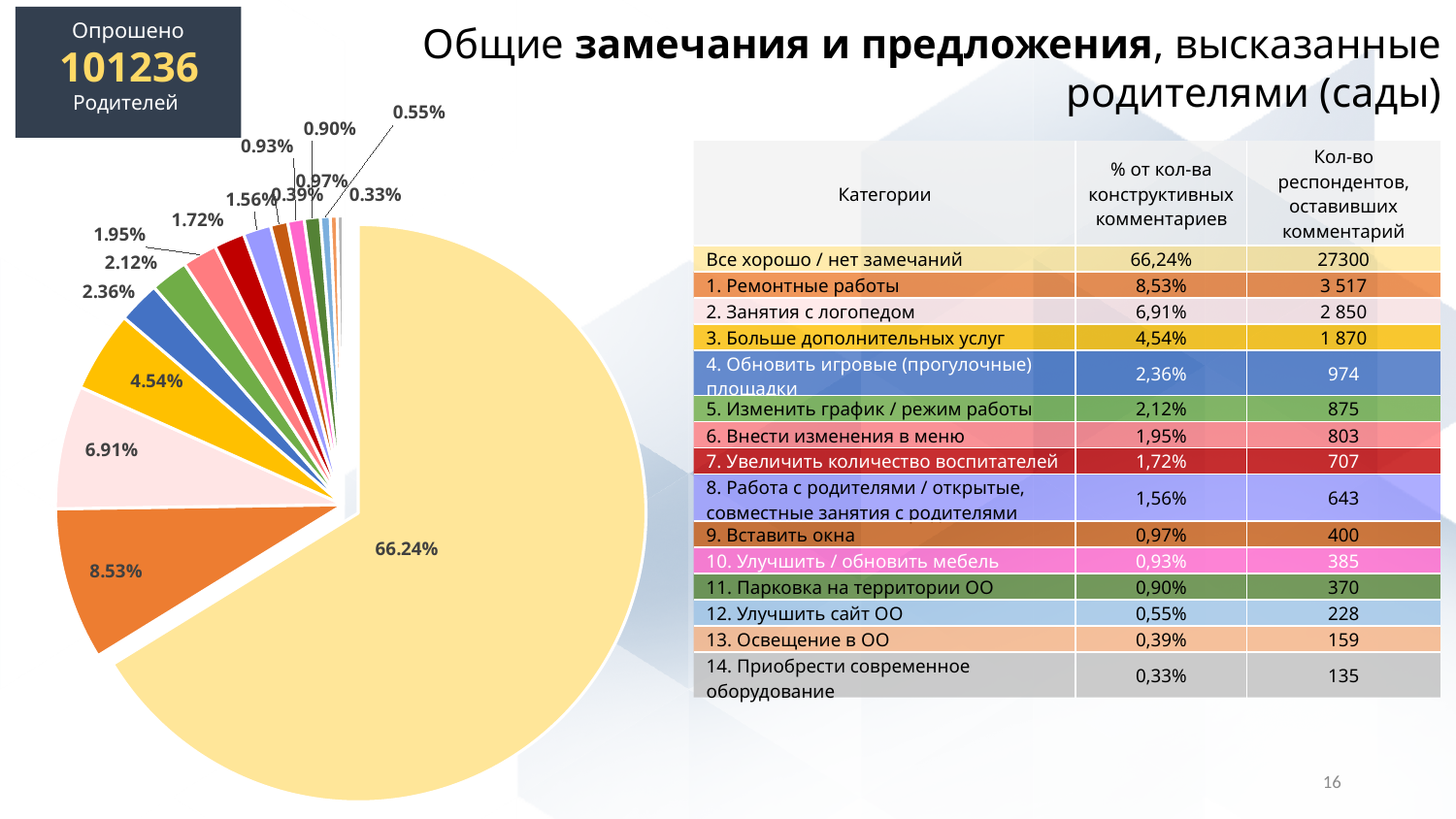
Is the share of the largest slice on the pie chart greater or less than 50%? greater What kind of chart is shown on the left of the slide? pie chart Which is larger on the pie chart: the slice labelled 4.54% or the slice labelled 2.36%? 4.54% What percentage does the light pink slice (Занятия с логопедом) show on the pie chart? 6.91% What colour is the largest slice of the pie chart? light yellow What is the difference between the 8.53% slice and the 6.91% slice on the pie chart? 1.62% How many slices does the pie chart have? 15 What is the difference between the largest slice (66.24%) and the second largest slice (8.53%) on the pie chart? 57.71% What percentage does the yellow slice (Больше дополнительных услуг) show on the pie chart? 4.54% What is the smallest percentage labelled on the pie chart? 0.33% What percentage does the orange slice (Ремонтные работы) show on the pie chart? 8.53% What percentage is shown on the largest slice of the pie chart? 66.24%